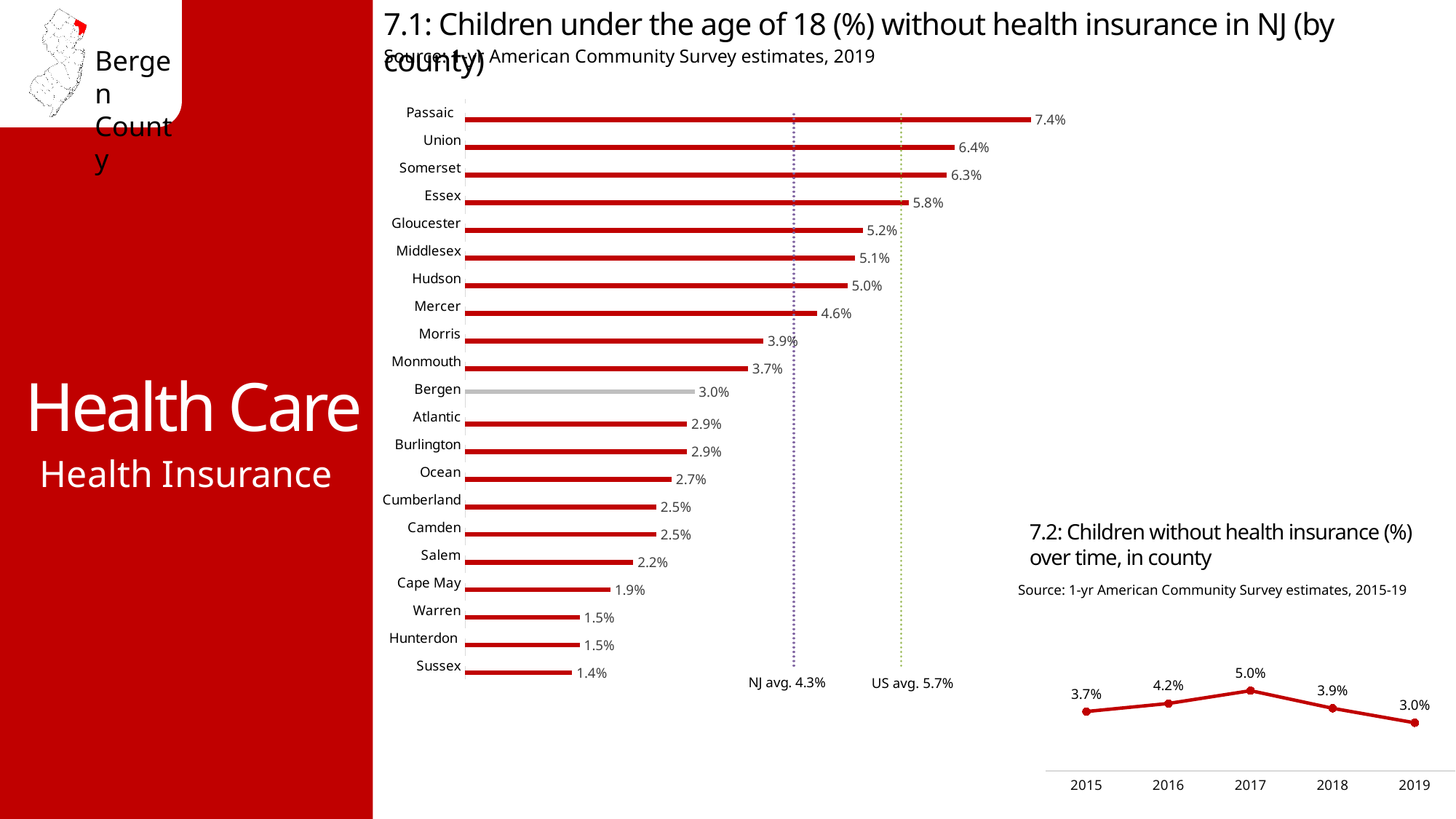
In chart 7.1 (children under 18 without health insurance by county), what is the difference between Passaic and Bergen? 4.4% In chart 7.1 (children under 18 without health insurance by county), how many counties are shown? 21 In chart 7.1 (children under 18 without health insurance by county), what NJ average is marked by the dotted line? 4.3% In chart 7.1 (children under 18 without health insurance by county), which is larger, the value for Union or the value for Essex? Union In chart 7.1 (children under 18 without health insurance by county), which county has the highest value? Passaic In chart 7.1 (children under 18 without health insurance by county), what is the value for Hudson? 5.0% In chart 7.2 (children without health insurance over time, in county), what is the value for 2017? 5.0% In chart 7.1 (children under 18 without health insurance by county), which county has the lowest value? Sussex In chart 7.1 (children under 18 without health insurance by county), what is the value for Bergen? 3.0% In chart 7.2 (children without health insurance over time, in county), which year has the highest value? 2017 What kind of chart is chart 7.2 (children without health insurance over time, in county)? Line chart In chart 7.2 (children without health insurance over time, in county), what is the difference between the 2017 and 2019 values? 2.0%